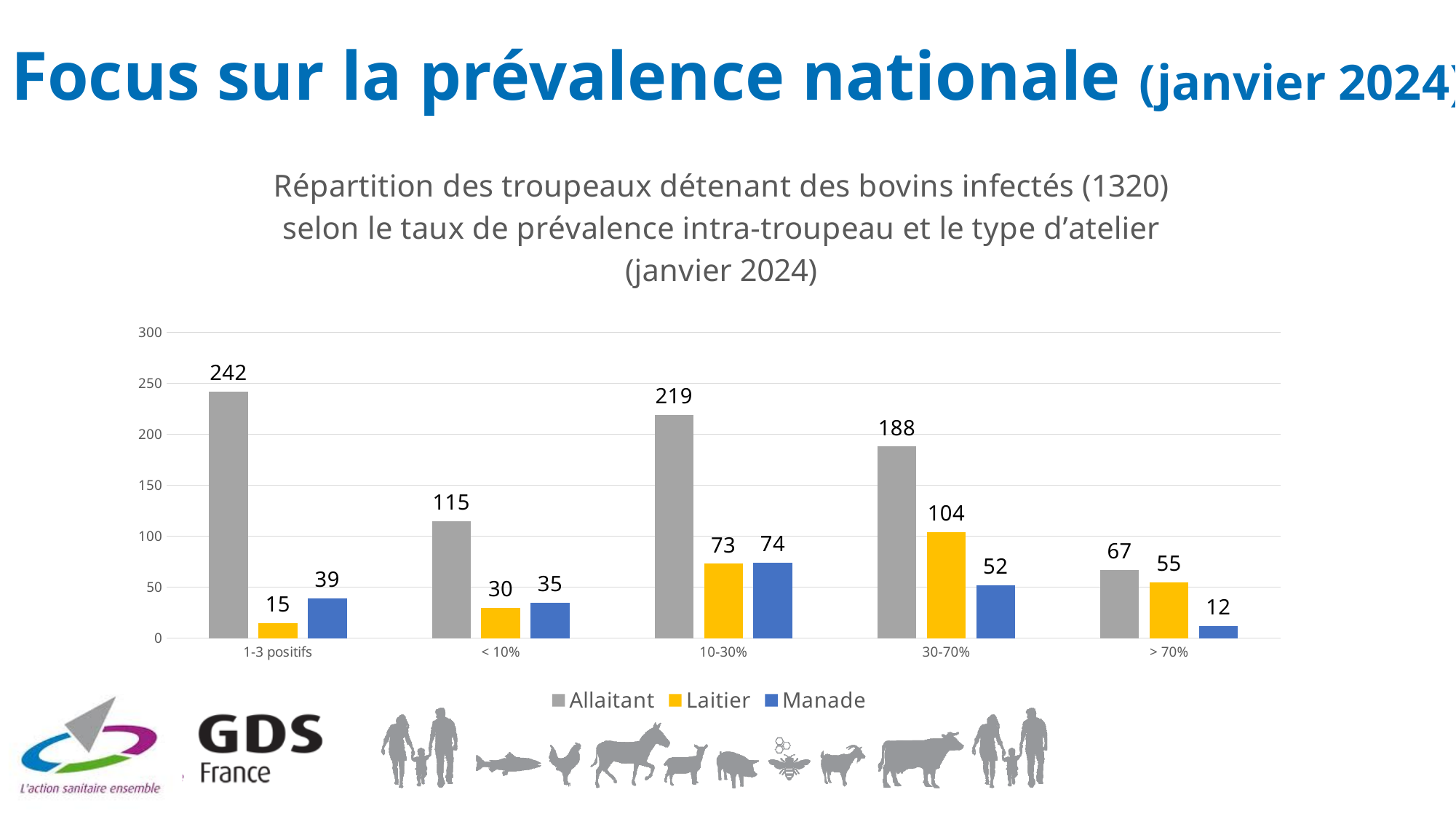
Which category has the lowest Laitier value? 1-3 positifs Which category has the highest Allaitant value? 1-3 positifs What is the value for Allaitant in the 1-3 positifs category? 242 What kind of chart is shown on the slide? bar chart What is the value for Manade in the > 70% category? 12 How many categories are shown on the x axis? 5 What is the value for Laitier in the 30-70% category? 104 In the < 10% category, which is larger, Laitier or Manade? Manade How many series does the legend list? 3 Which colour represents the Manade series? blue Is the Allaitant value for 30-70% greater or less than 150? greater What is the difference between the Allaitant and Laitier values in the 10-30% category? 146